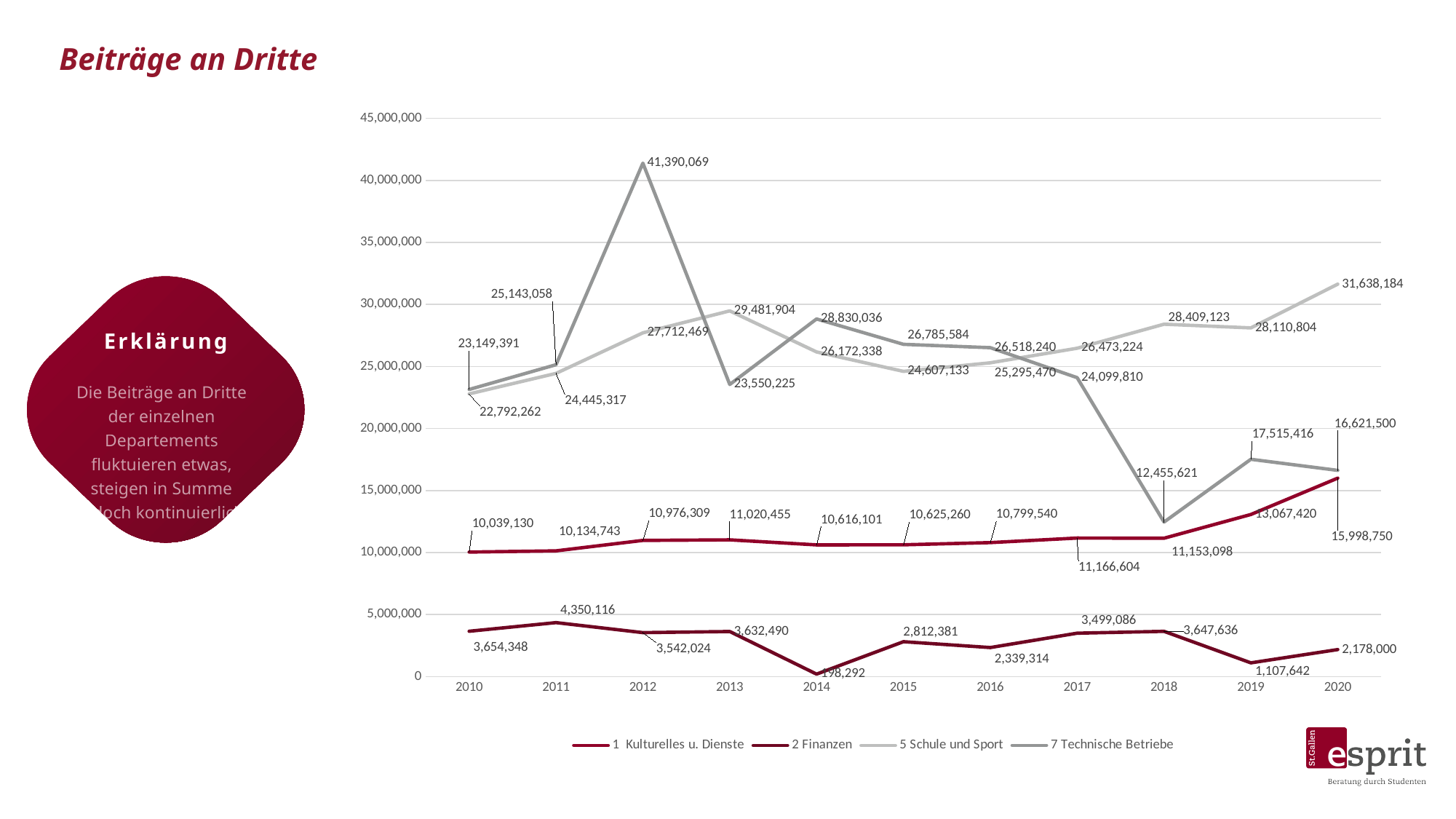
What is the value for 1 Kulturelles u. Dienste in 2019? 13,067,420 How many series does the legend list? 4 What is the difference between the 2020 values of 5 Schule und Sport and 7 Technische Betriebe? 15,016,684 In which year does 7 Technische Betriebe reach its highest value? 2012 Which series has the larger value in 2018: 1 Kulturelles u. Dienste or 7 Technische Betriebe? 7 Technische Betriebe What is the value for 5 Schule und Sport in 2020? 31,638,184 How many years are plotted along the x axis? 11 What is the title of the chart? Beiträge an Dritte What is the value for 2 Finanzen in 2014? 198,292 What is the value for 7 Technische Betriebe in 2012? 41,390,069 What kind of chart is shown on the slide? Line chart In which year does 2 Finanzen have its lowest value? 2014